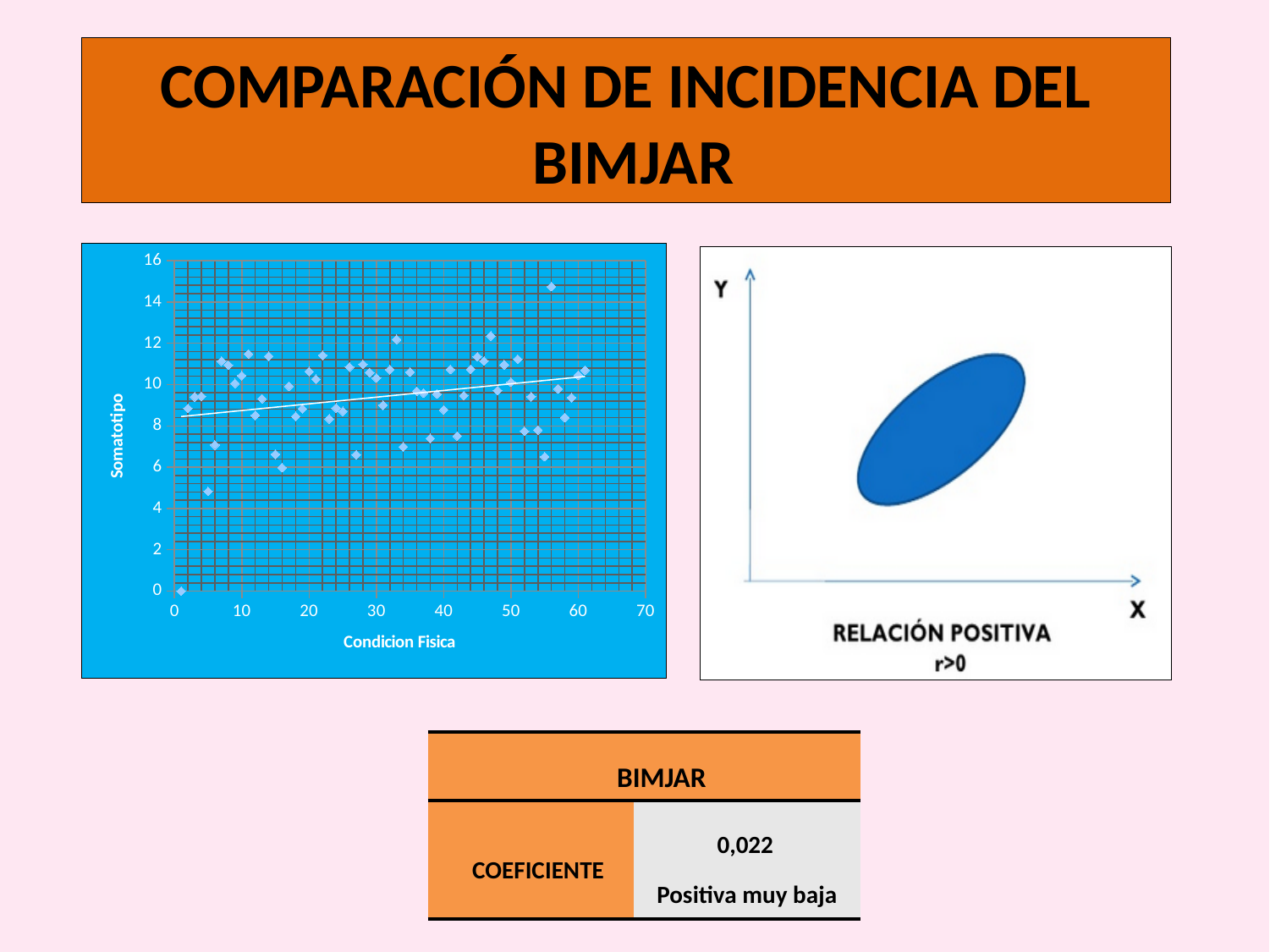
In the left chart, what is the title of the horizontal axis? Condicion Fisica What kind of chart is shown on the left of the slide? scatter chart In the left chart, what is the title of the vertical axis? Somatotipo In the left chart, does the fitted trend line rise or fall as Condicion Fisica increases? rise In the left chart, is the trend line at Condicion Fisica = 60 greater or less than 8? greater In the left chart, is the largest Condicion Fisica value plotted greater or less than 70? less Does the left chart show a positive or negative relationship between Condicion Fisica and Somatotipo? positive In the left chart, is the trend line at Condicion Fisica = 0 greater or less than 10? less